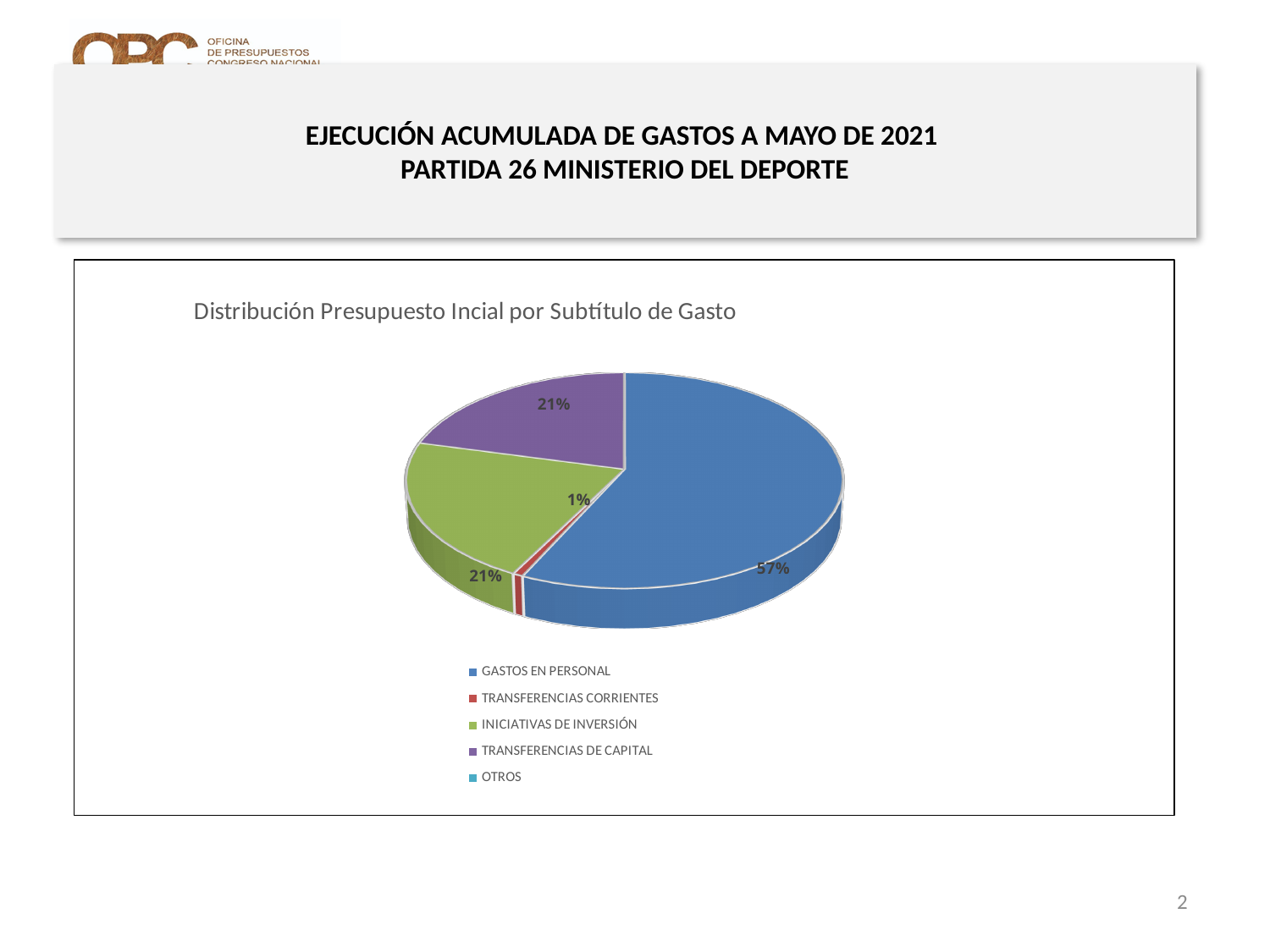
Which category has the largest slice of the pie? GASTOS EN PERSONAL How many categories does the legend list? 5 What percentage is shown for TRANSFERENCIAS CORRIENTES? 1% What percentage is shown for TRANSFERENCIAS DE CAPITAL? 21% What colour is the slice for GASTOS EN PERSONAL? Blue Which is larger, the slice for GASTOS EN PERSONAL or the slice for INICIATIVAS DE INVERSIÓN? GASTOS EN PERSONAL What is the title of the chart? Distribución Presupuesto Incial por Subtítulo de Gasto By how many percentage points does GASTOS EN PERSONAL exceed TRANSFERENCIAS DE CAPITAL? 36 percentage points What kind of chart is shown on the slide? Pie chart What percentage of the pie does GASTOS EN PERSONAL represent? 57% What percentage is shown for INICIATIVAS DE INVERSIÓN? 21%